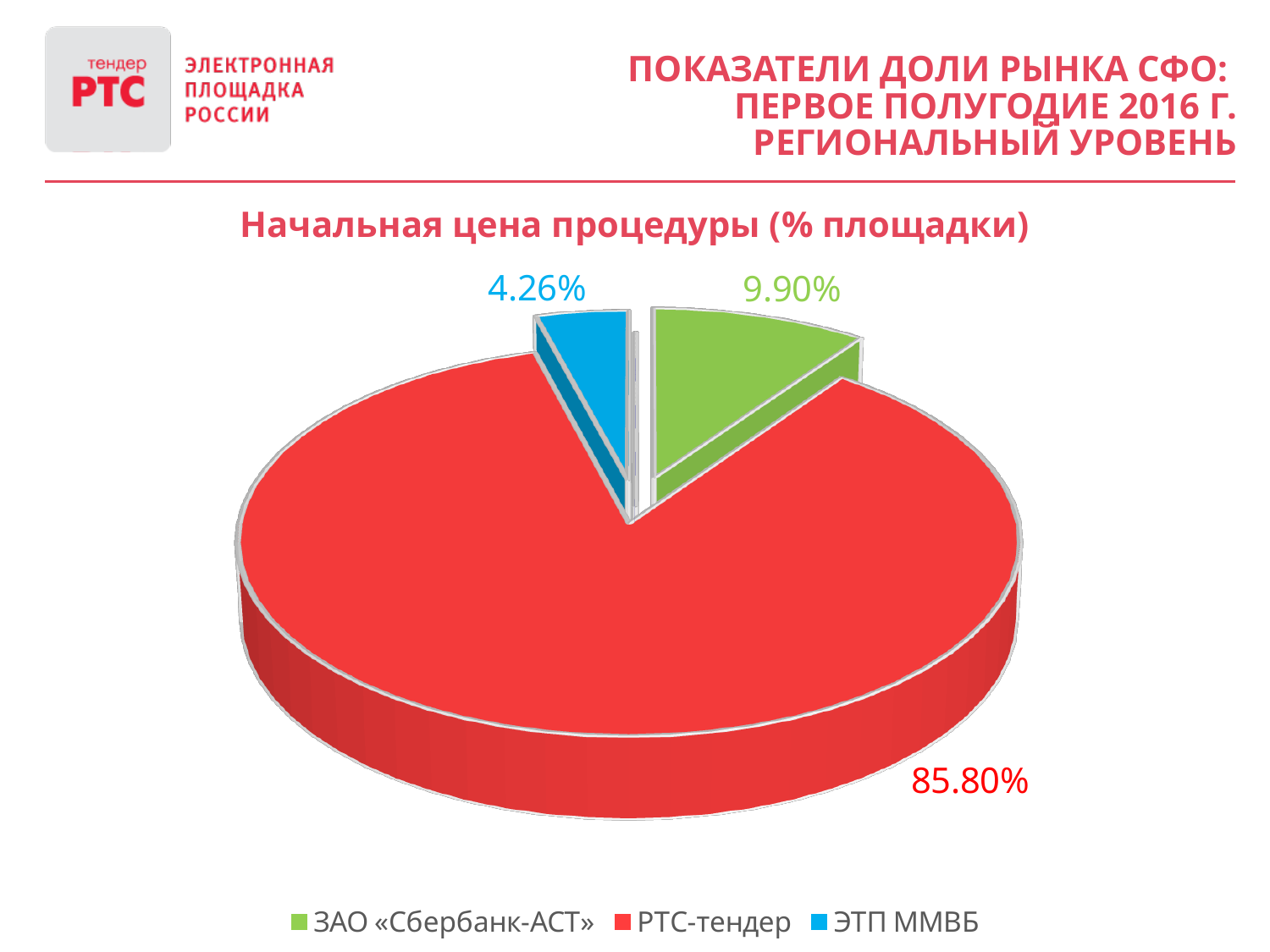
What is the title of the chart? Начальная цена процедуры (% площадки) What is the difference between the shares of ЗАО «Сбербанк-АСТ» and ЭТП ММВБ? 5.64% What kind of chart is shown on the slide? pie chart What is the share for ЭТП ММВБ? 4.26% Which is larger, the share of ЗАО «Сбербанк-АСТ» or the share of ЭТП ММВБ? ЗАО «Сбербанк-АСТ» Which category has the largest slice of the pie? РТС-тендер What is the share for РТС-тендер? 85.80% Which colour represents ЭТП ММВБ in the chart? blue What is the difference between the shares of РТС-тендер and ЗАО «Сбербанк-АСТ»? 75.90% How many slices does the pie chart have? 3 Which category has the smallest slice of the pie? ЭТП ММВБ What is the share for ЗАО «Сбербанк-АСТ»? 9.90%